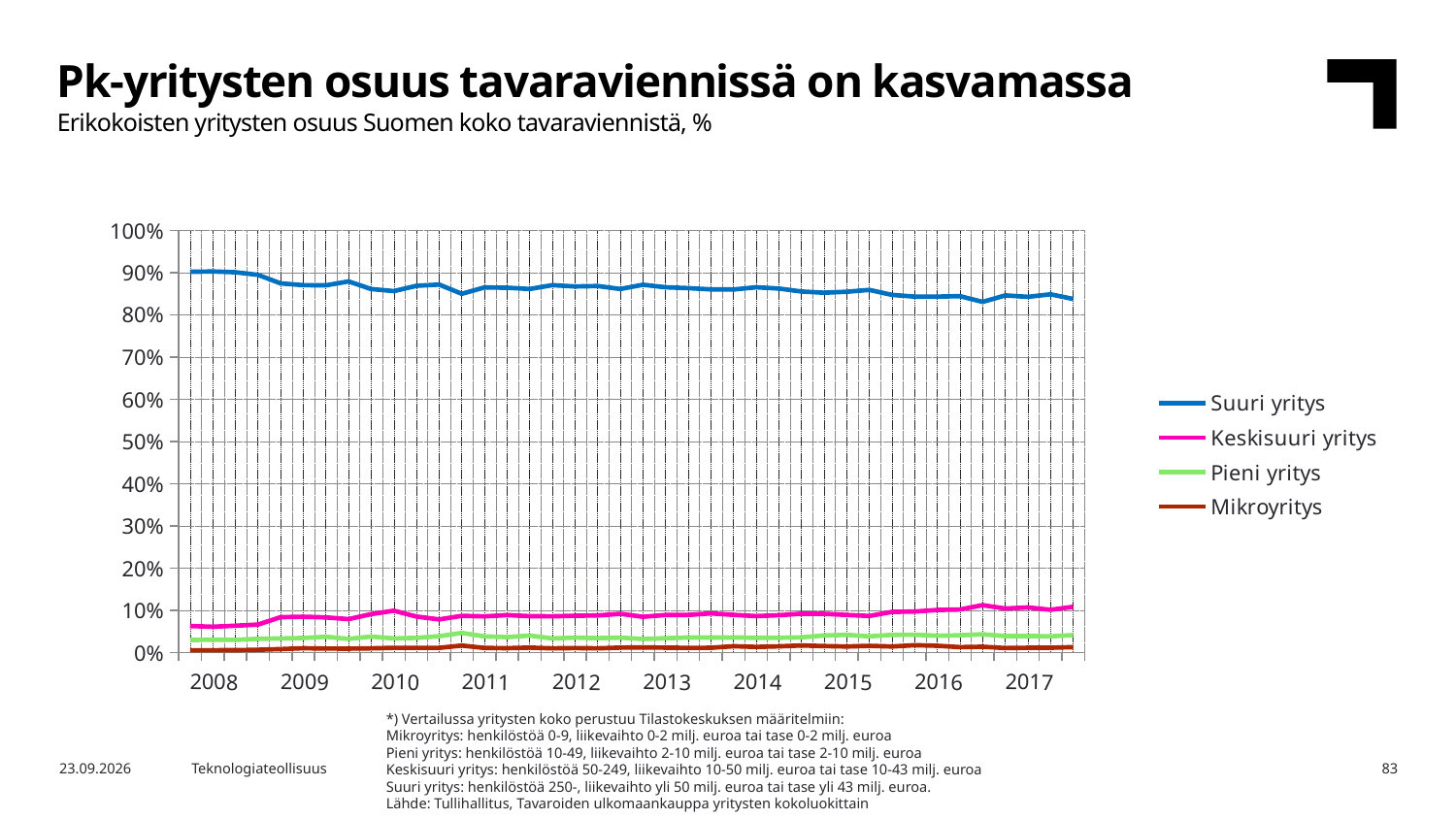
Is the value for Suuri yritys at the start of 2008 greater or less than 80%? greater How many series does the legend list? 4 Does the share for Keskisuuri yritys rise or fall from 2008 to 2017? rise Which series has the highest share of exports throughout the period? Suuri yritys Which series has the lowest share of exports throughout the period? Mikroyritys What kind of chart is shown on the slide? line chart Is the value for Suuri yritys at the end of 2017 greater or less than 90%? less In 2017, which is larger: the share for Keskisuuri yritys or for Pieni yritys? Keskisuuri yritys What colour is the line for Suuri yritys? blue Is the value for Keskisuuri yritys in 2017 greater or less than 20%? less How many years are labelled on the x axis? 10 Does the share for Suuri yritys rise or fall from 2008 to 2017? fall